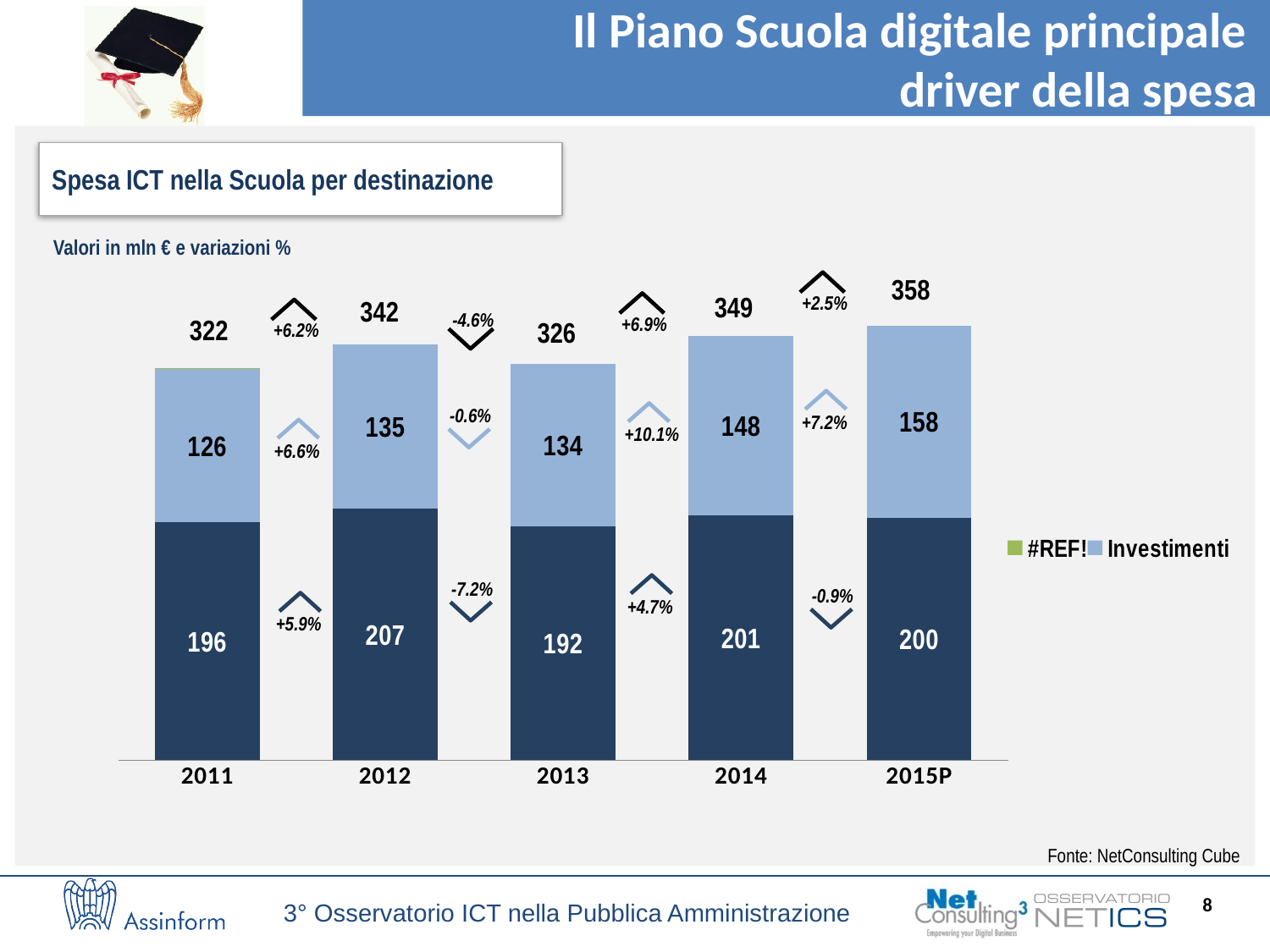
How many years are shown on the x axis? 5 What percentage change in Investimenti is shown between 2013 and 2014? +10.1% What percentage change in the total is shown between 2012 and 2013? -4.6% Which year has the lowest total value? 2011 What is the title of the chart? Spesa ICT nella Scuola per destinazione Is the Investimenti value larger in 2013 or in 2015P? 2015P Which year has the highest total value? 2015P What type of chart is shown on the slide? Stacked bar chart What is the difference between the total for 2015P and the total for 2011? 36 What is the total ICT spending in schools shown for 2012? 342 What is the Investimenti value for 2014? 148 What is the Investimenti value for 2011? 126